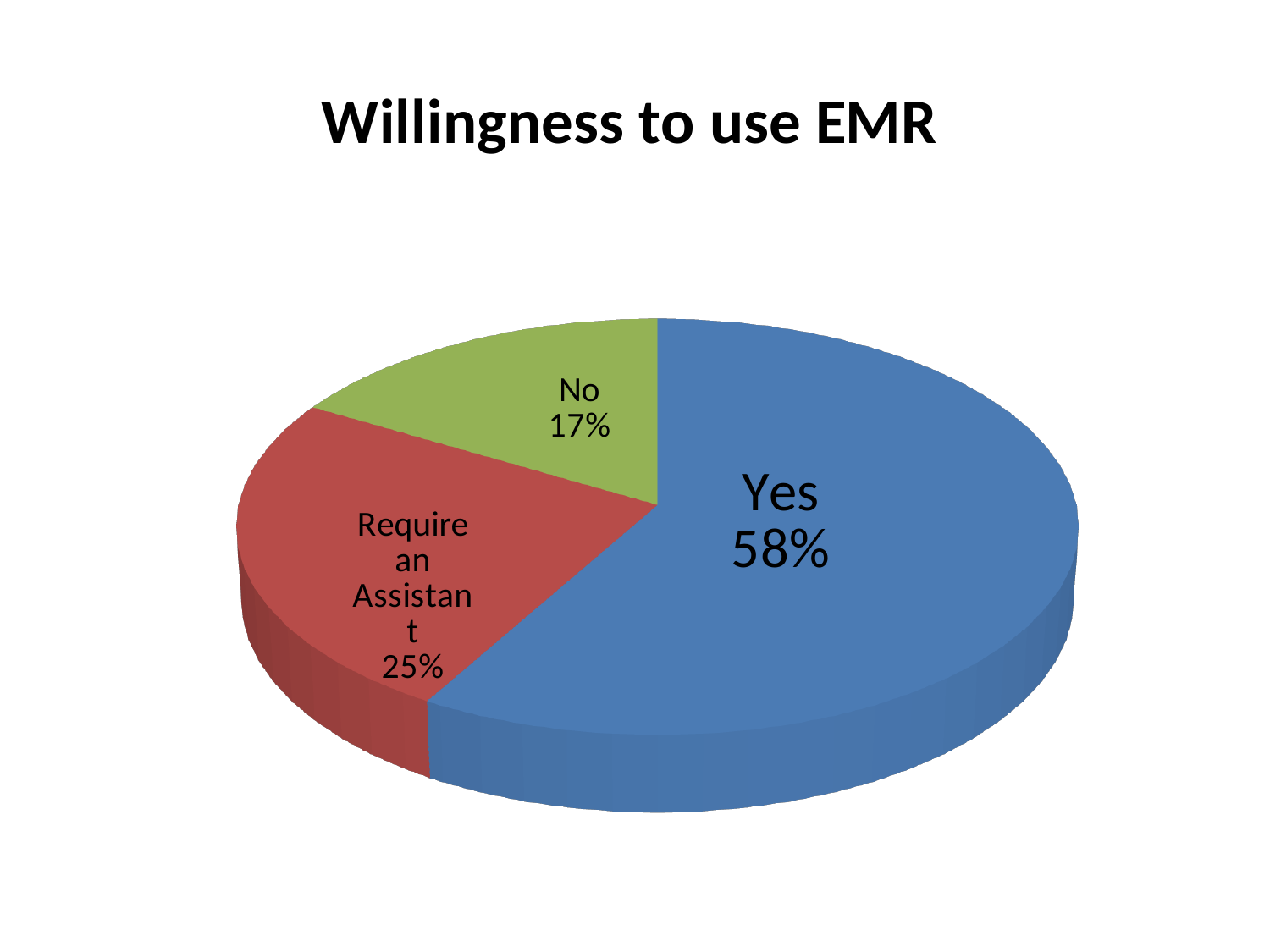
What share of the pie is the Yes slice? 58% What colour is the Yes slice? blue What is the title of the chart? Willingness to use EMR What kind of chart is shown on the slide? pie chart What is the difference in percentage points between the Require an Assistant slice and the No slice? 8 Which slice is the smallest? No What share of the pie is the Require an Assistant slice? 25% Which slice is the largest? Yes What share of the pie is the No slice? 17% How many slices does the pie chart have? 3 What is the difference in percentage points between the Yes slice and the No slice? 41 Which is larger, the Require an Assistant slice or the No slice? Require an Assistant